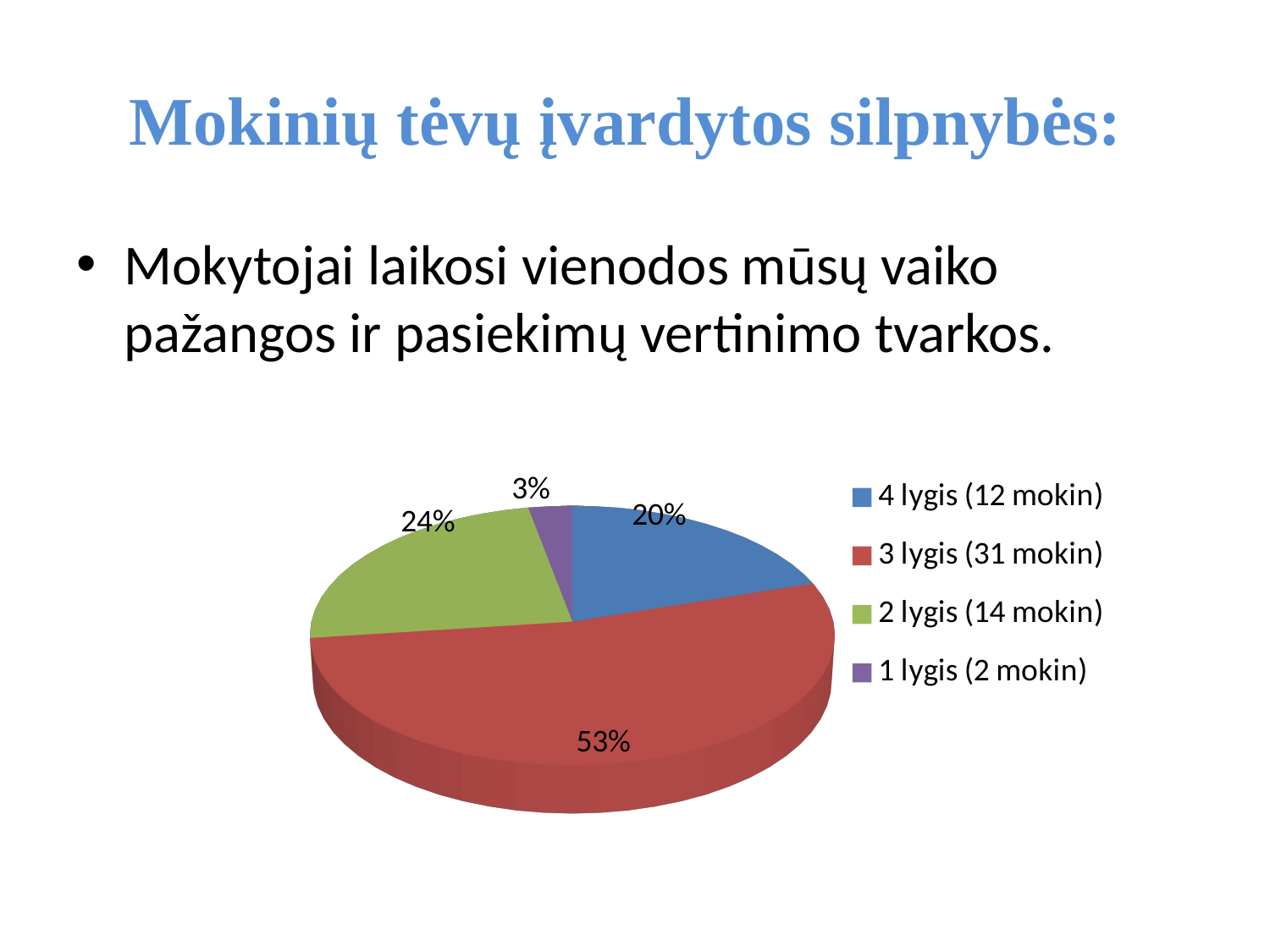
What percentage share does the slice for "1 lygis (2 mokin)" have? 3% How many entries does the legend list? 4 Which category has the largest slice of the pie? 3 lygis (31 mokin) What kind of chart is shown on the slide? pie chart What percentage share does the slice for "4 lygis (12 mokin)" have? 20% Which category has the smallest slice of the pie? 1 lygis (2 mokin) How many slices does the pie chart have? 4 What is the difference in percentage points between the "3 lygis" slice and the "2 lygis" slice? 29 What colour is the slice for "1 lygis (2 mokin)"? purple Which slice is larger: "2 lygis (14 mokin)" or "4 lygis (12 mokin)"? 2 lygis (14 mokin) What percentage share does the slice for "2 lygis (14 mokin)" have? 24% What percentage share does the slice for "3 lygis (31 mokin)" have? 53%